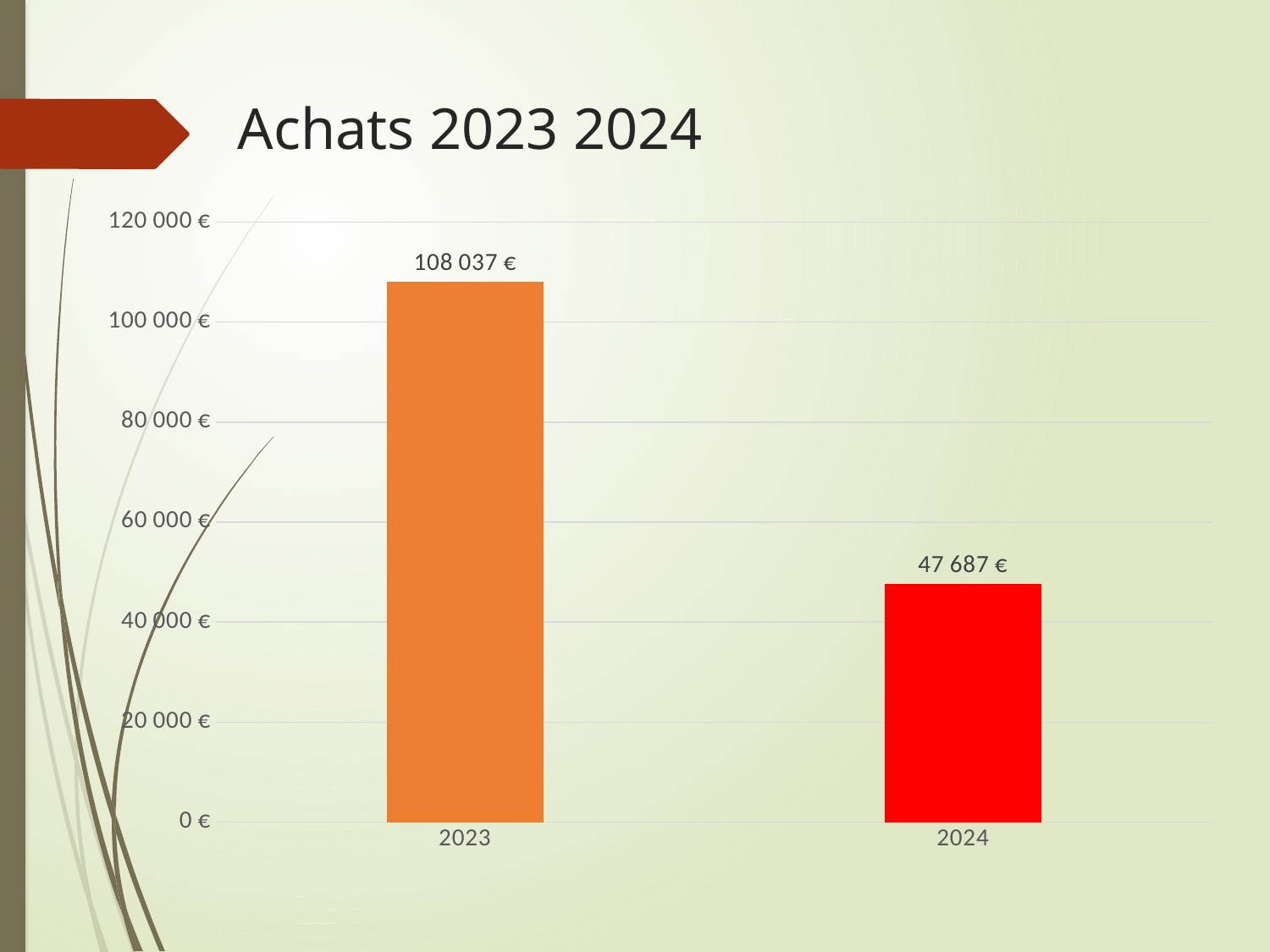
Is the value for 2024 greater or less than 60 000 €? less What is the title of the slide? Achats 2023 2024 What is the difference between the values for 2023 and 2024? 60 350 € What is the value for 2024? 47 687 € Which year has the lowest value? 2024 Do the values rise or fall from 2023 to 2024? fall What is the value for 2023? 108 037 € Which is larger, the value for 2023 or the value for 2024? 2023 Is the value for 2023 greater or less than 100 000 €? greater What kind of chart is shown on the slide? bar chart Which year has the highest value? 2023 How many categories are shown on the x axis? 2